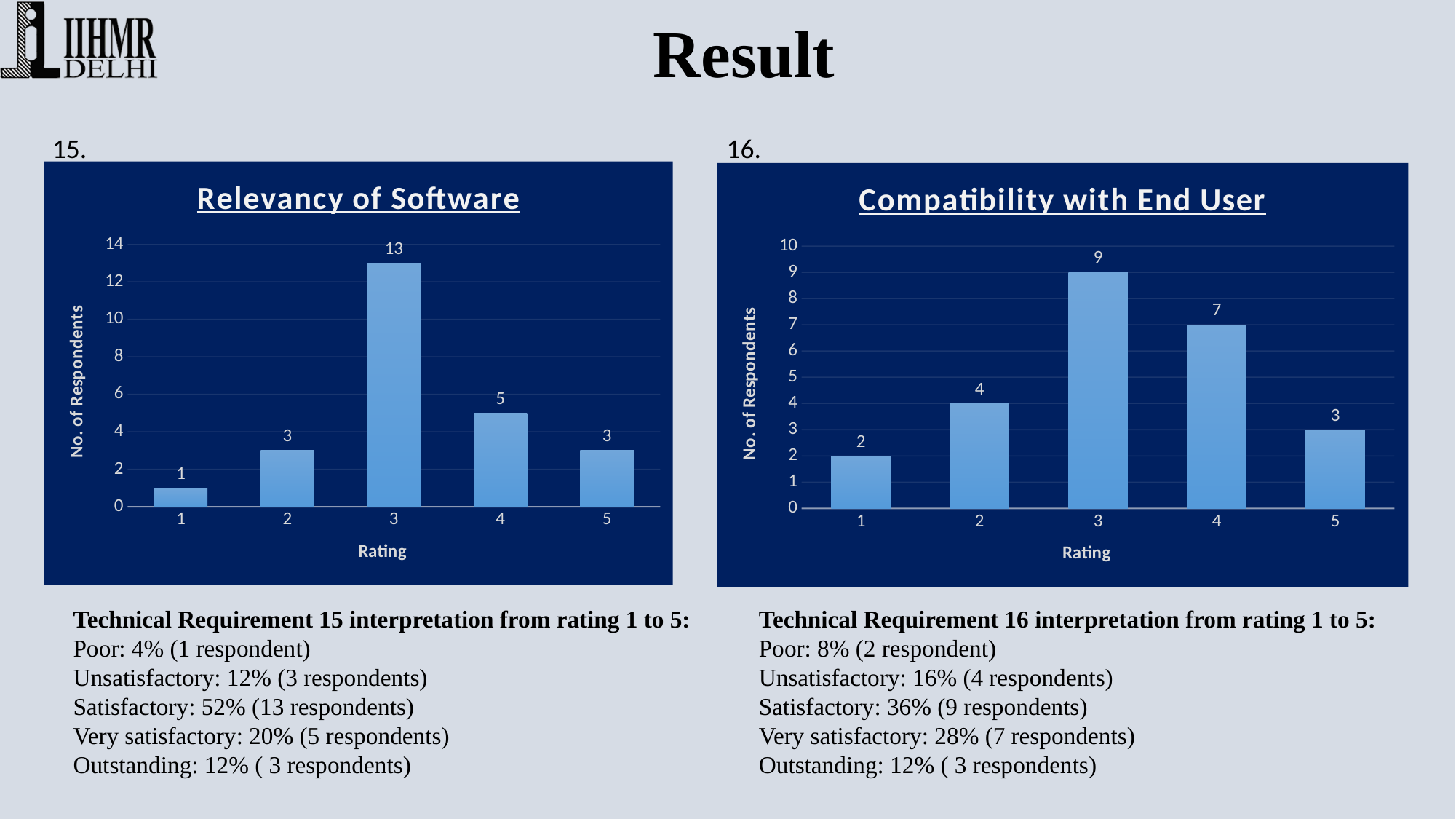
In the 'Relevancy of Software' chart, what is the difference between the number of respondents for rating 3 and rating 4? 8 What kind of chart is the 'Relevancy of Software' chart? Bar chart In the 'Relevancy of Software' chart, how many respondents gave a rating of 3? 13 How many rating categories are shown on the x axis of the 'Compatibility with End User' chart? 5 In the 'Compatibility with End User' chart, do the values rise or fall from rating 1 to rating 3? Rise In the 'Compatibility with End User' chart, what is the difference between the number of respondents for rating 3 and rating 2? 5 In the 'Compatibility with End User' chart, which rating has the lowest number of respondents? 1 In the 'Compatibility with End User' chart, which rating has more respondents, rating 2 or rating 5? Rating 2 In the 'Compatibility with End User' chart, how many respondents gave a rating of 4? 7 In the 'Relevancy of Software' chart, is the value for rating 3 greater or less than 12? greater In the 'Relevancy of Software' chart, which rating has the highest number of respondents? 3 What is the y-axis label of the 'Relevancy of Software' chart? No. of Respondents